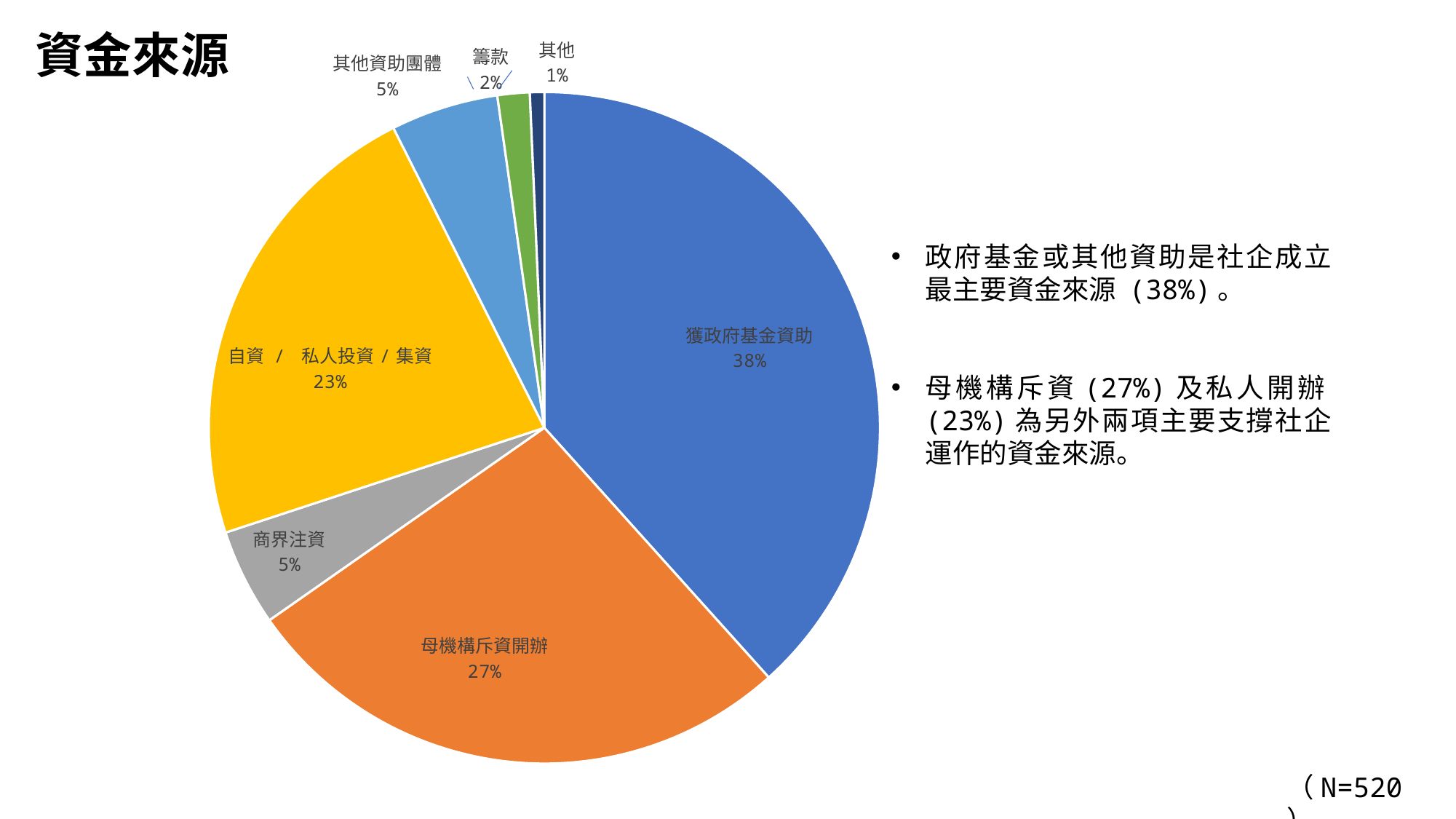
What kind of chart is shown on the slide? pie chart How many slices does the pie chart have? 7 Which is larger, 母機構斥資開辦 or 自資 / 私人投資 / 集資? 母機構斥資開辦 What percentage is shown for 籌款? 2% What share of the pie does 獲政府基金資助 represent? 38% What percentage is shown for 母機構斥資開辦? 27% Which category has the largest slice of the pie? 獲政府基金資助 What percentage is shown for 自資 / 私人投資 / 集資? 23% What is the combined share of 商界注資 and 其他資助團體? 10% Which category has the smallest slice of the pie? 其他 What is the difference in percentage points between 獲政府基金資助 and 母機構斥資開辦? 11 What is the title of the chart? 資金來源